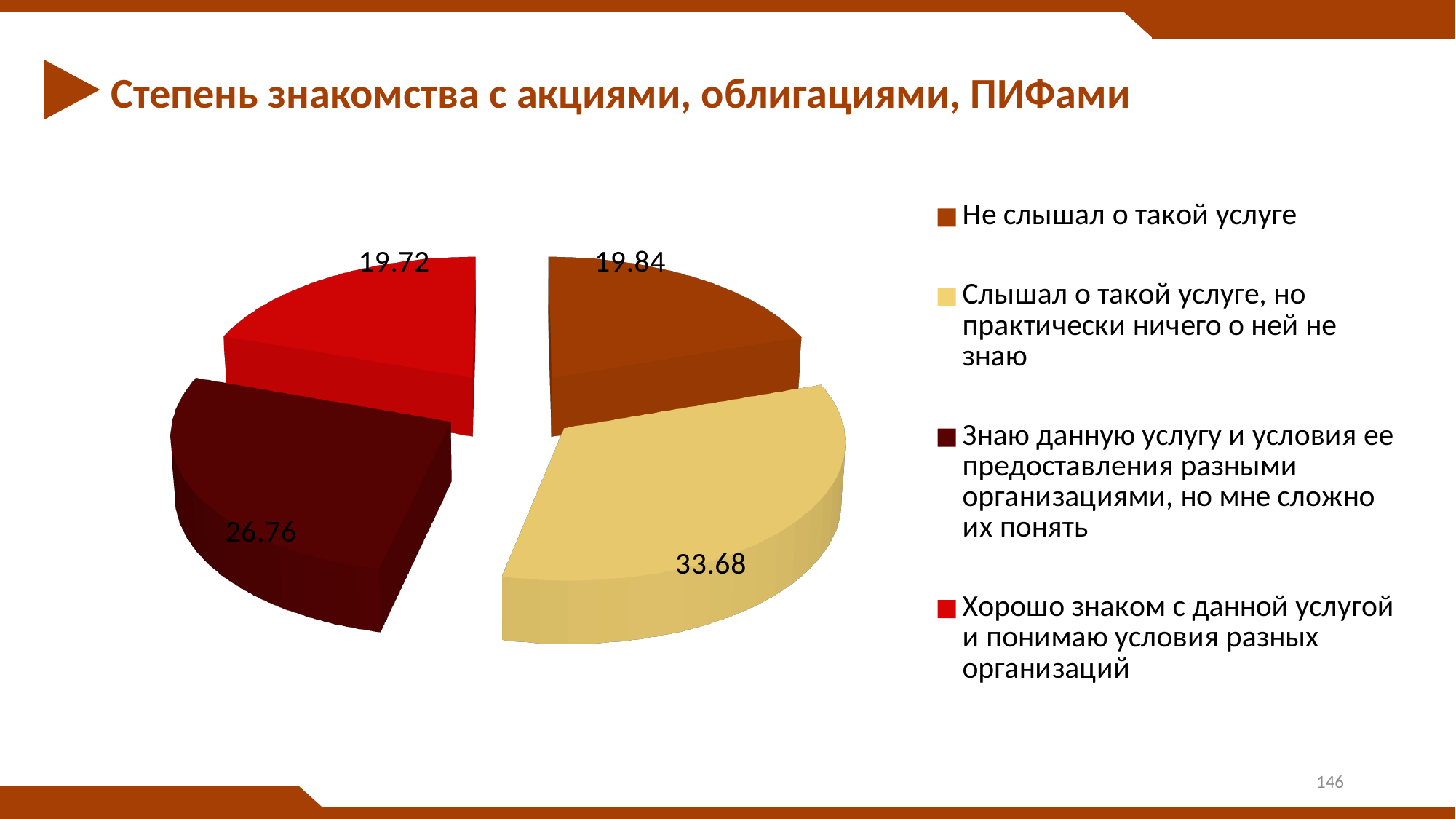
Which category has the largest slice of the pie? Слышал о такой услуге, но практически ничего о ней не знаю How many slices does the pie chart have? 4 What colour is the slice for "Не слышал о такой услуге"? brown Which is larger: the value for "Не слышал о такой услуге" or the value for "Хорошо знаком с данной услугой и понимаю условия разных организаций"? Не слышал о такой услуге What is the value for "Не слышал о такой услуге"? 19.84 Which category has the smallest slice of the pie? Хорошо знаком с данной услугой и понимаю условия разных организаций What kind of chart is shown on the slide? pie chart What is the value for "Слышал о такой услуге, но практически ничего о ней не знаю"? 33.68 What is the value for "Хорошо знаком с данной услугой и понимаю условия разных организаций"? 19.72 What is the difference between the values for "Слышал о такой услуге, но практически ничего о ней не знаю" and "Знаю данную услугу и условия ее предоставления разными организациями, но мне сложно их понять"? 6.92 What is the value for "Знаю данную услугу и условия ее предоставления разными организациями, но мне сложно их понять"? 26.76 What is the title of the slide? Степень знакомства с акциями, облигациями, ПИФами